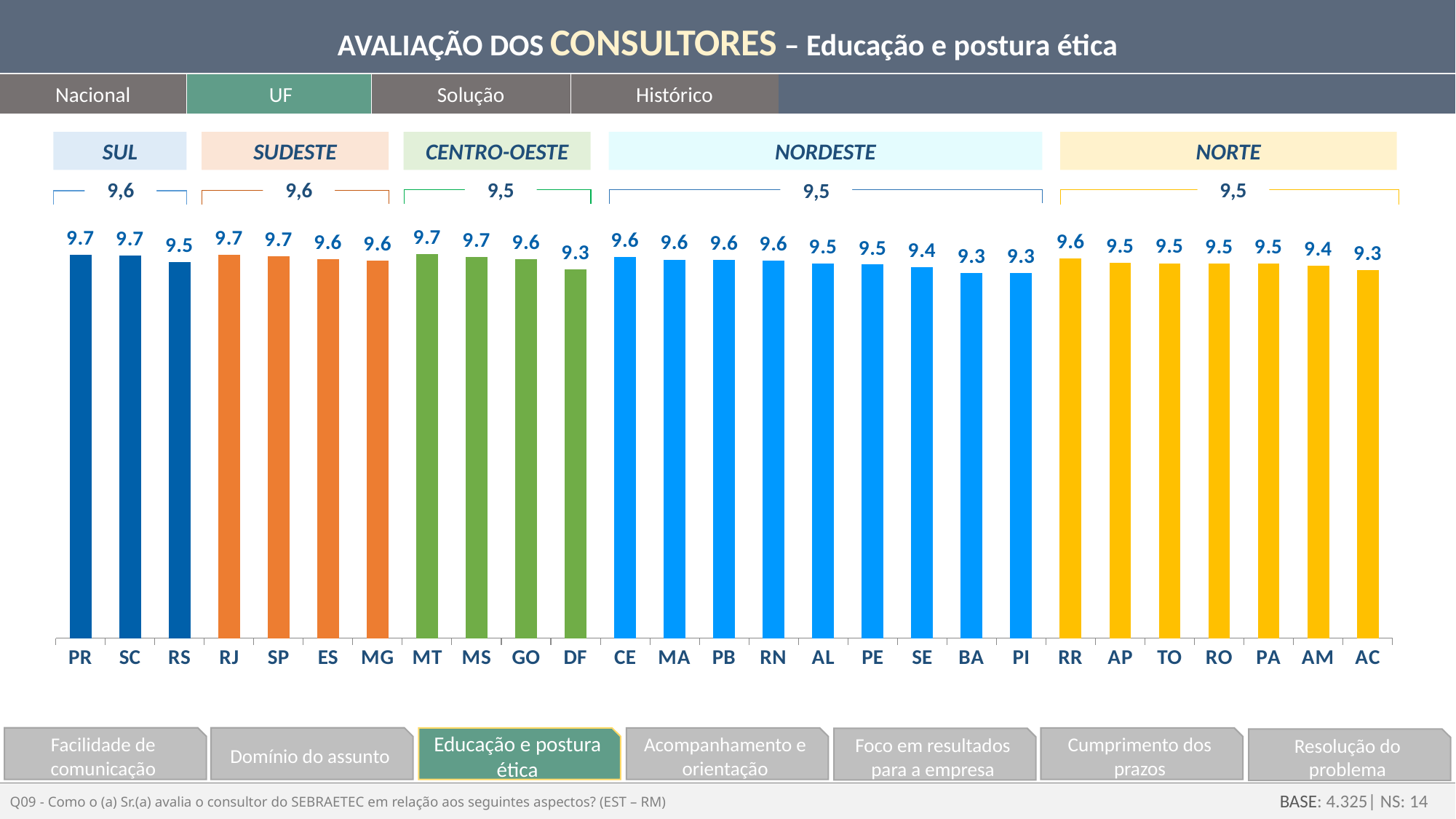
Which state in the SUL group has the lowest value? RS Which state in the NORTE group has the lowest value? AC What is the value for SE? 9.4 Which has a larger value, CE or PI? CE What is the value for DF? 9.3 Which state in the NORTE group has the highest value? RR How many states are shown in the chart? 27 What is the difference between the values for MT and DF? 0.4 What is the value for PR? 9.7 What is the regional average shown for NORDESTE? 9,5 What kind of chart is shown on the slide? Bar chart Within the NORDESTE group, do the values rise or fall from CE to PI? Fall